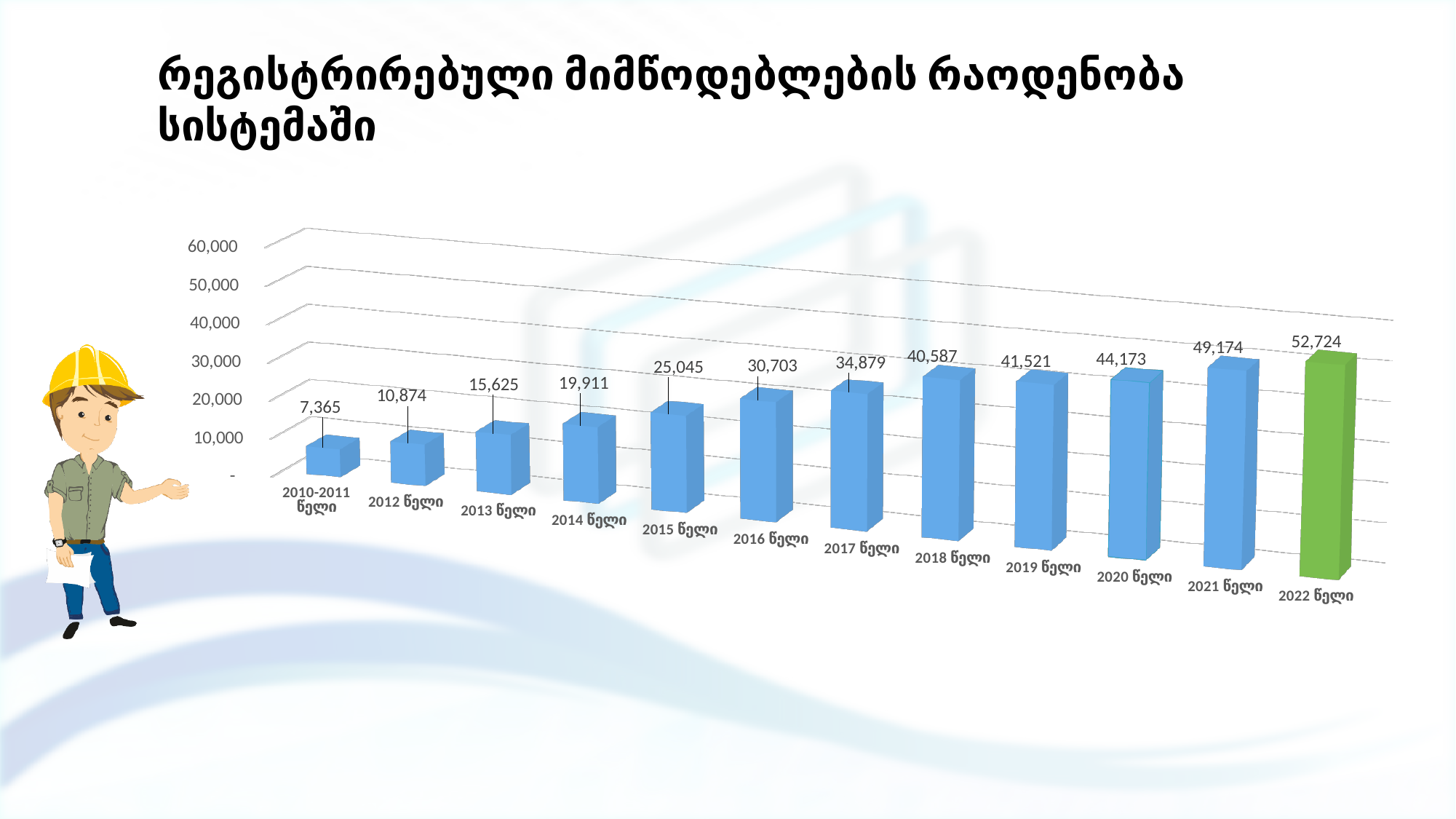
How many categories are shown on the x axis? 12 Is the value for 2017 წელი greater or less than 30,000? greater What is the difference between the values for 2019 წელი and 2018 წელი? 934 Which category has the lowest value? 2010-2011 წელი Which is larger, the value for 2014 წელი or the value for 2015 წელი? 2015 წელი What is the value for 2010-2011 წელი? 7,365 What kind of chart is shown on the slide? bar chart Which category has the highest value? 2022 წელი What is the value for 2016 წელი? 30,703 What is the value for 2022 წელი? 52,724 What is the difference between the values for 2022 წელი and 2021 წელი? 3,550 Do the values rise or fall from left to right along the x axis? rise